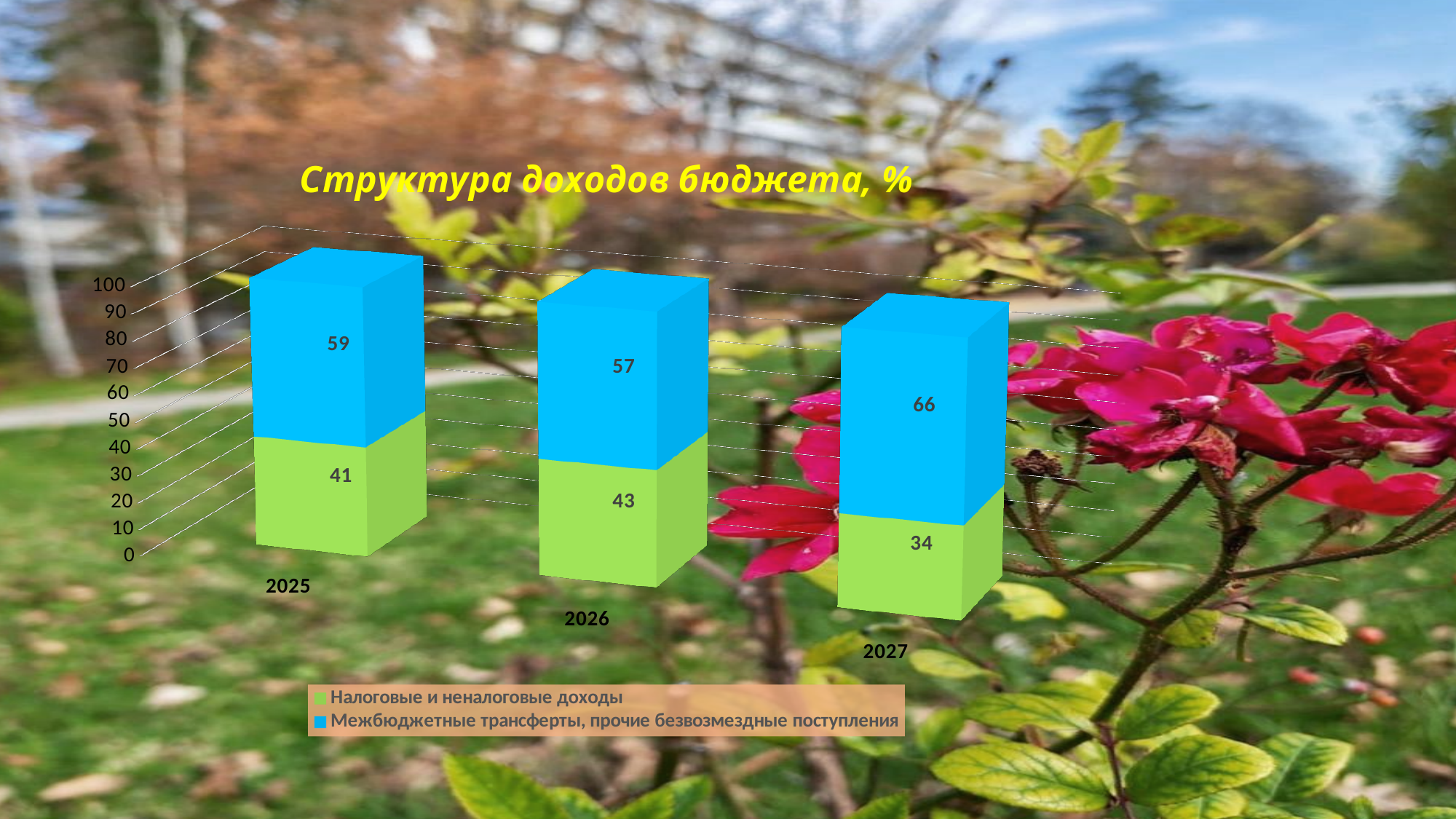
What kind of chart is shown on the slide? Stacked bar chart What is the value for 'Налоговые и неналоговые доходы' in 2026? 43 What is the value for 'Налоговые и неналоговые доходы' in 2025? 41 In which year is the value for 'Налоговые и неналоговые доходы' lowest? 2027 Which is larger in 2026: 'Налоговые и неналоговые доходы' or 'Межбюджетные трансферты, прочие безвозмездные поступления'? Межбюджетные трансферты, прочие безвозмездные поступления How many years are shown on the x axis? 3 What is the total of the stacked bar for 2026? 100 What is the title of the chart? Структура доходов бюджета, % How many series does the legend list? 2 In which year is the value for 'Межбюджетные трансферты, прочие безвозмездные поступления' highest? 2027 What is the difference between the 'Межбюджетные трансферты, прочие безвозмездные поступления' values for 2027 and 2025? 7 What is the value for 'Межбюджетные трансферты, прочие безвозмездные поступления' in 2027? 66